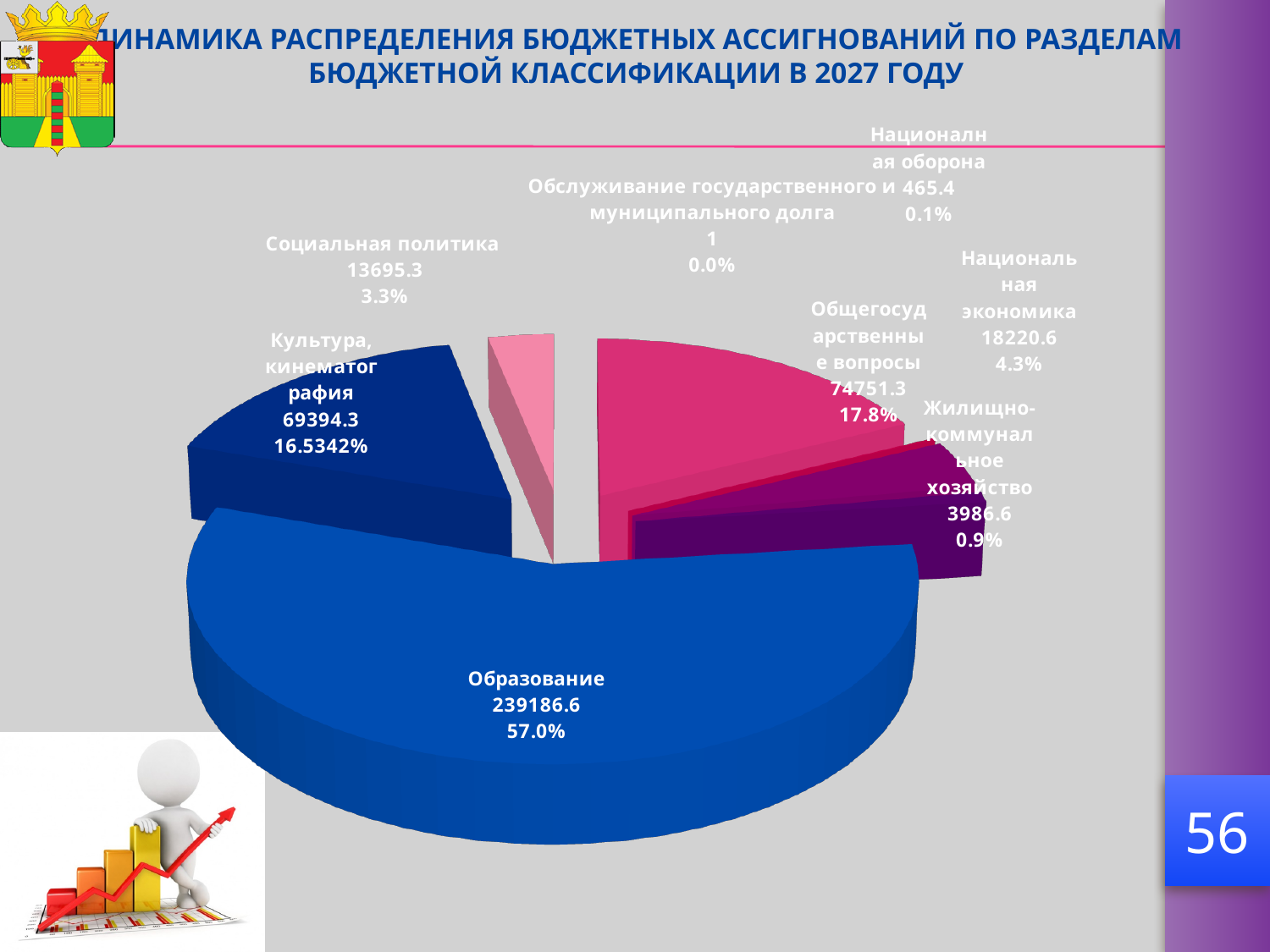
Which is larger, the value for Социальная политика or the value for Национальная экономика? Национальная экономика What kind of chart is shown on the slide? pie chart What is the difference between the values for Общегосударственные вопросы and Культура, кинематография? 5357.0 Which category has the largest share of the pie? Образование What share of the pie does Культура, кинематография represent? 16.5342% Which category has the smallest value in the pie? Обслуживание государственного и муниципального долга What share of the pie does Жилищно-коммунальное хозяйство represent? 0.9% What share of the pie does Образование represent? 57.0% What is the value shown for Национальная экономика? 18220.6 How many categories are shown in the pie chart? 8 What is the value shown for Общегосударственные вопросы? 74751.3 What is the value shown for Образование? 239186.6